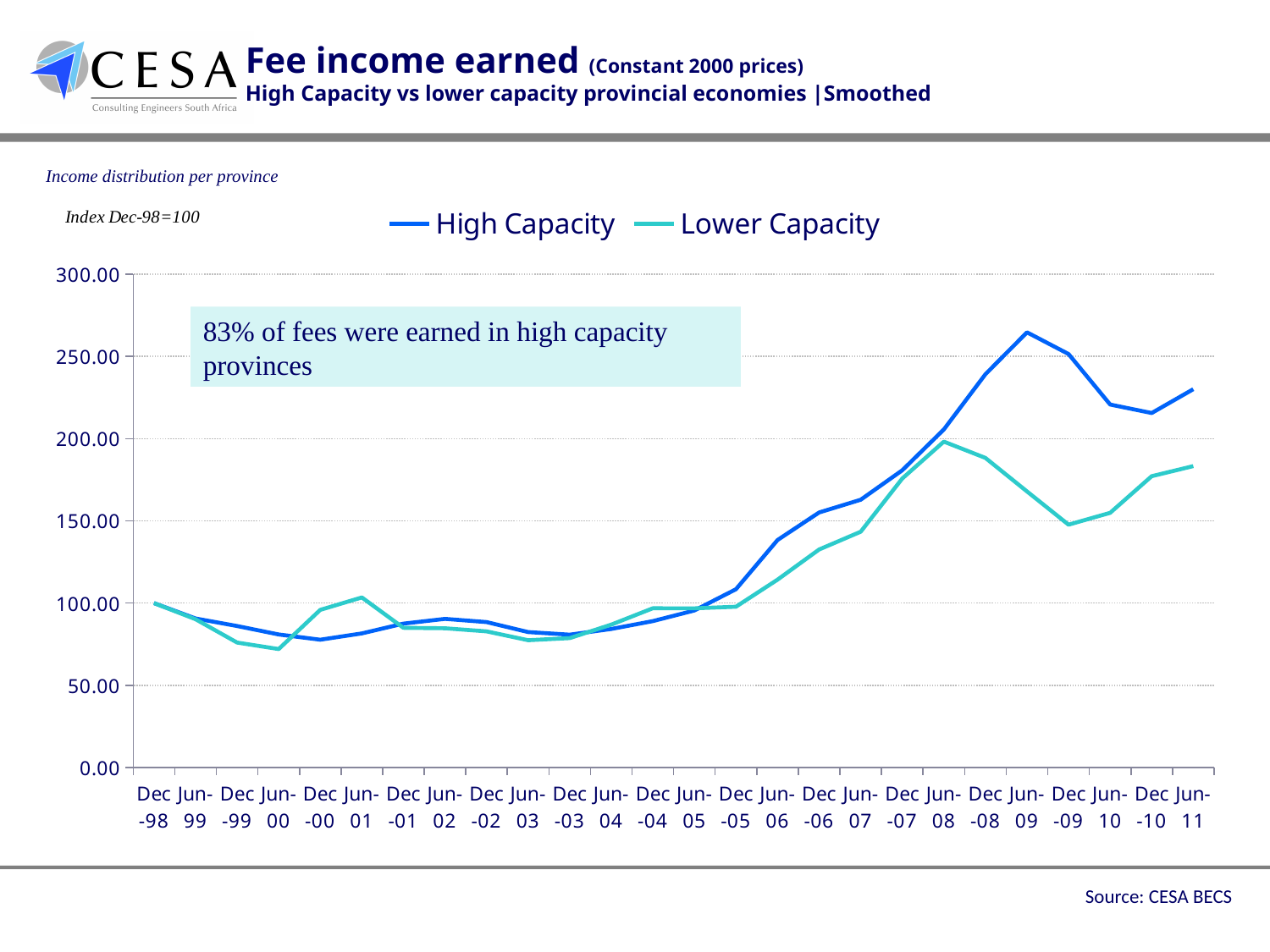
How many series does the legend list? 2 What are the two series named in the legend? High Capacity and Lower Capacity What kind of chart is shown on the slide? Line chart How many time points are shown along the x axis? 26 Does the High Capacity series rise or fall between Dec-05 and Jun-09? Rise Is the value for Lower Capacity at Jun-00 greater or less than 100? less Is the value for High Capacity at Jun-11 greater or less than 200? greater At which x-axis point does the High Capacity series reach its highest value? Jun-09 Is the value for High Capacity at Jun-09 greater or less than 250? greater What is the index value for High Capacity at Dec-98? 100.00 At which x-axis point does the Lower Capacity series reach its highest value? Jun-08 At Jun-09, which series has the higher value, High Capacity or Lower Capacity? High Capacity